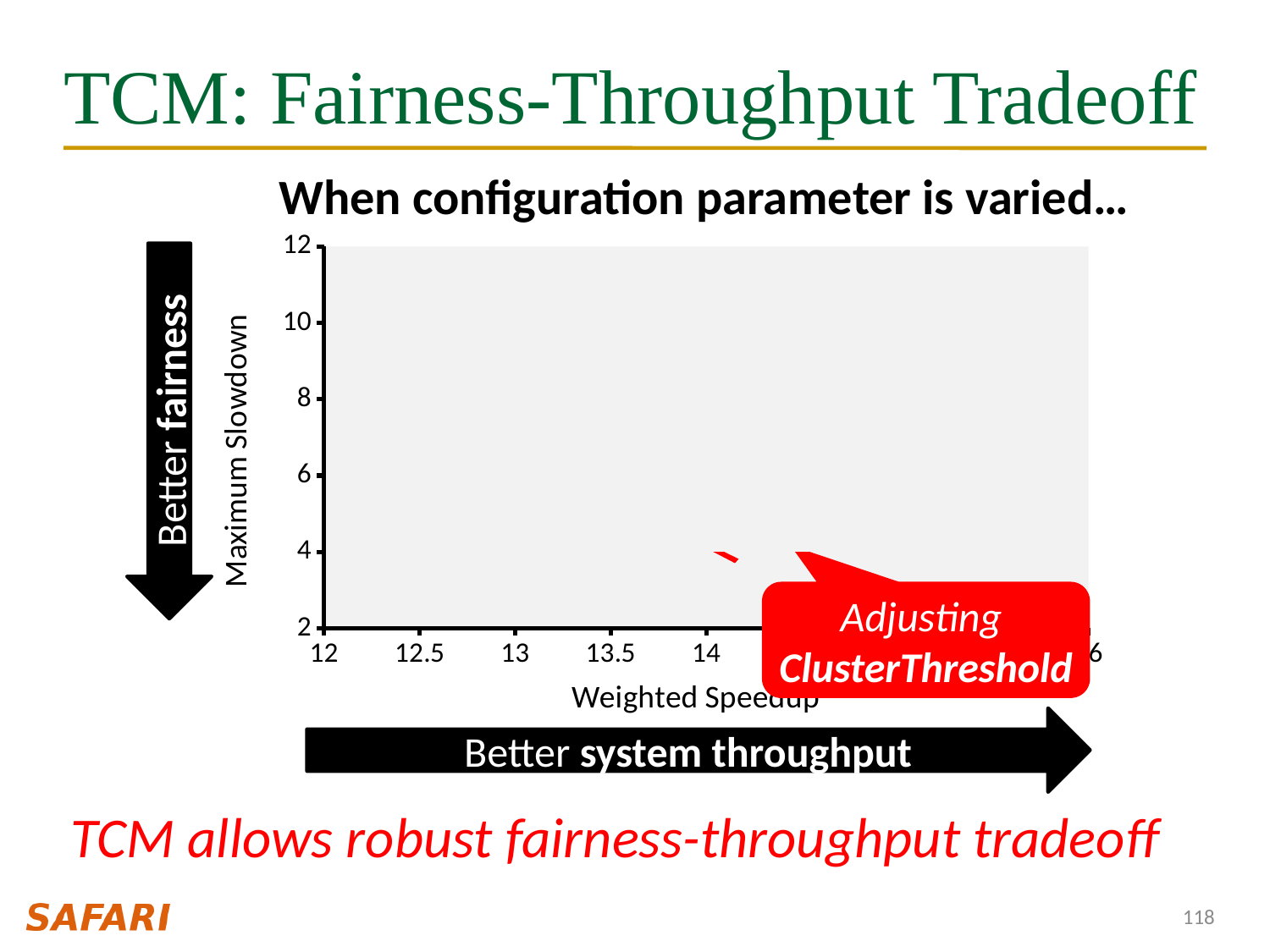
What is the title shown above the chart? When configuration parameter is varied… Is the Maximum Slowdown of the visible red data point near a Weighted Speedup of 14 greater or less than 6? less What is the label of the chart's horizontal axis? Weighted Speedup